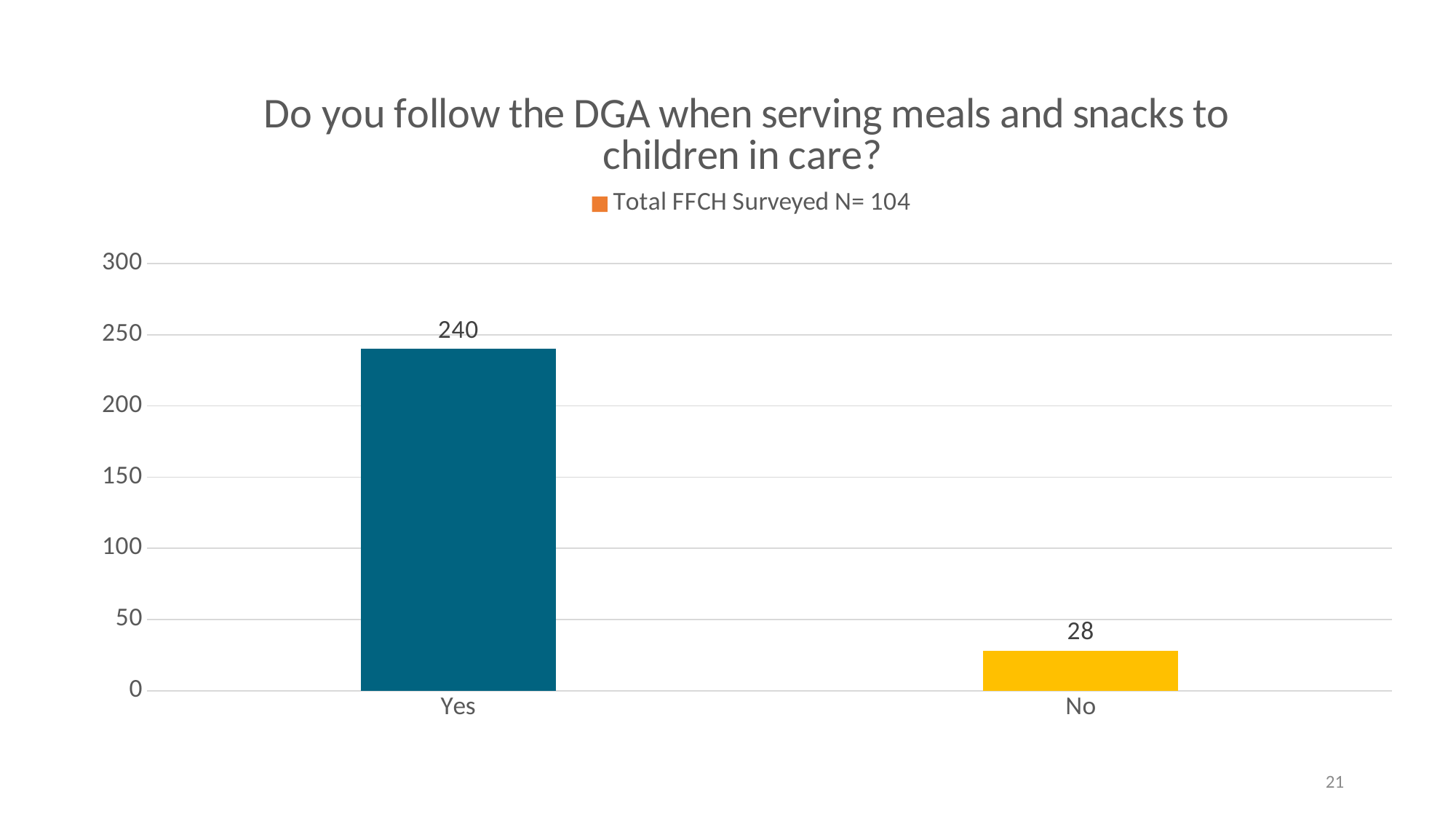
Which category has the lowest value? No Which category has the highest value? Yes Which is larger, the value for Yes or the value for No? Yes How many categories are shown on the x axis? 2 What is the legend entry shown on the chart? Total FFCH Surveyed N= 104 What is the value for Yes? 240 Is the value for Yes greater or less than 200? greater What kind of chart is shown on the slide? bar chart What is the difference between the values for Yes and No? 212 Is the value for No greater or less than 50? less What is the value for No? 28 How many series does the legend list? 1